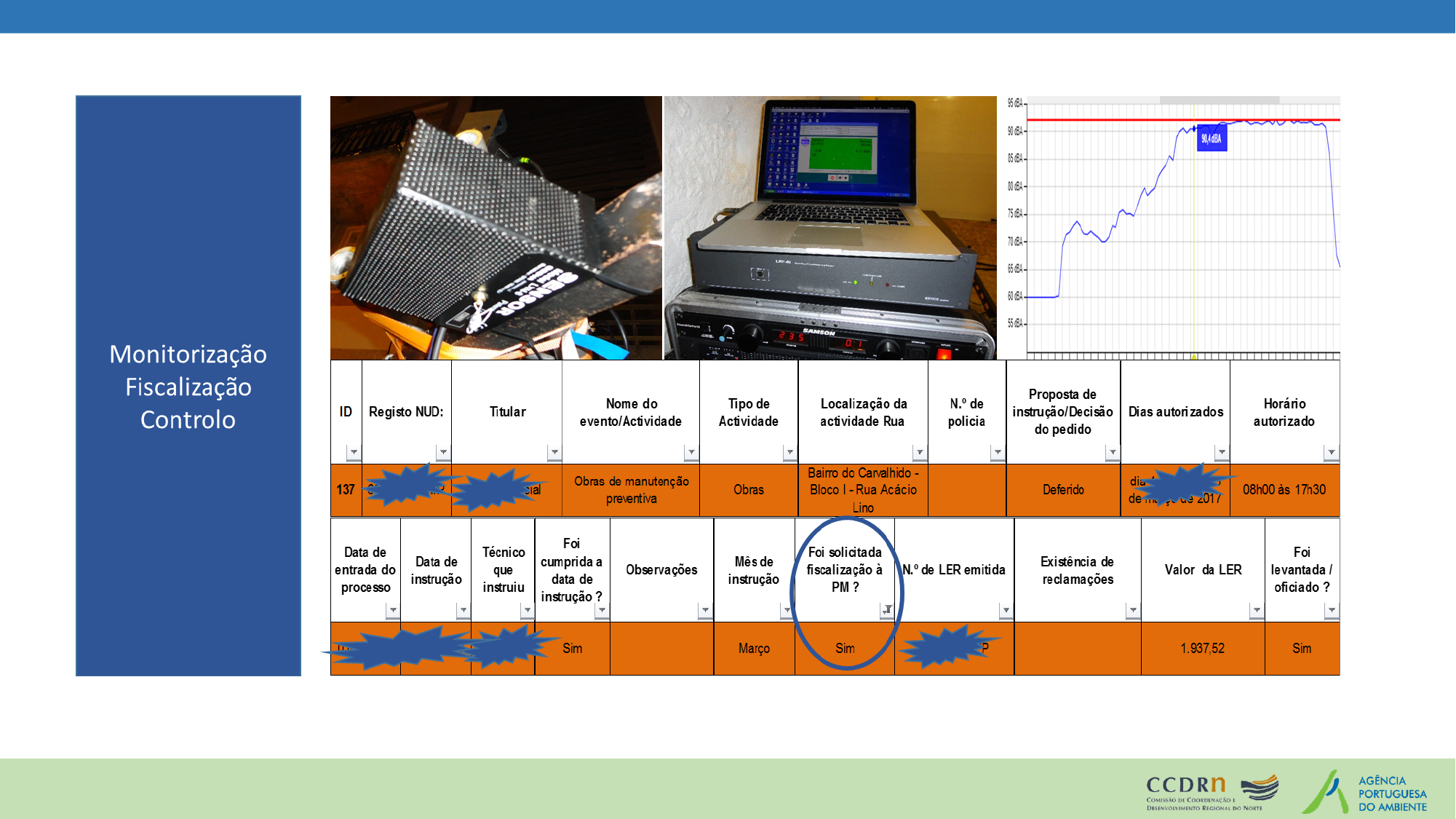
In the top-right chart, does the line mainly rise or fall from the left side up to the labelled point? rise What kind of chart is shown in the top right of the slide? line chart What is the highest tick label on the vertical axis of the top-right chart? 95 dBA In the top-right chart, is the value at the start of the line greater or less than 70 dBA? less What colour is the plotted line in the top-right chart? blue In the top-right chart, what value is printed on the data label attached to the line? 90,4 dBA How many data lines are plotted in the top-right chart? 1 In the top-right chart, is the highest point of the line greater or less than 85 dBA? greater In the top-right chart, is the value at the very end of the line greater or less than 70 dBA? less